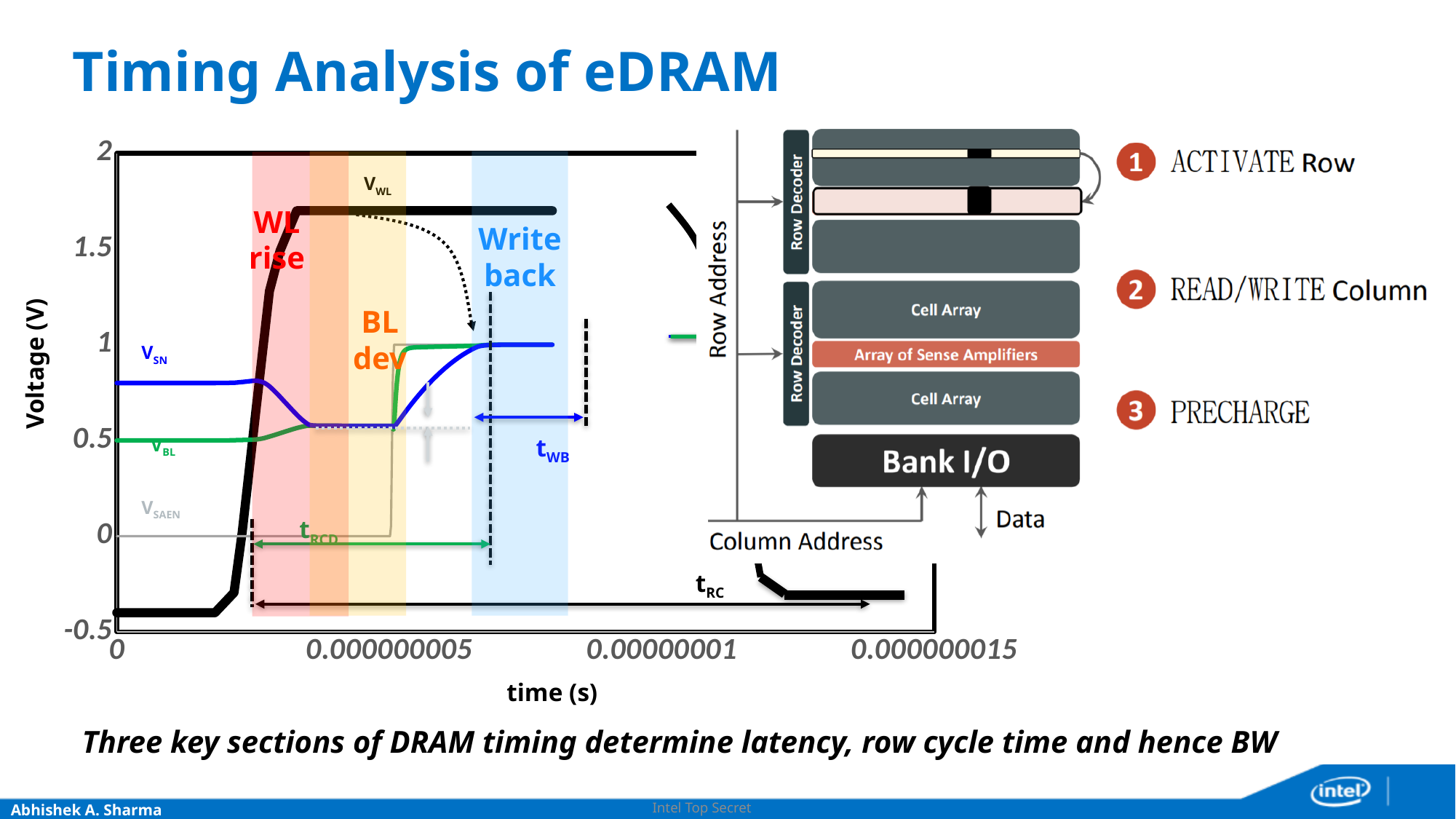
What is the label of the y axis of the chart? Voltage (V) What is the label of the x axis of the chart? time (s) Which labeled trace reaches the highest voltage in the chart? V_WL Does the V_SN trace rise or fall during the blue 'Write back' region? rise Is the plateau value of the V_WL trace greater or less than 1.5 V? greater At time 0, which trace has the higher voltage, V_SN or V_BL? V_SN Is the initial value of the V_SN trace (at time 0) greater or less than 0.5 V? greater What kind of chart is shown on the left of the slide? line chart Is the initial value of the V_BL trace (at time 0) greater or less than 1 V? less Does the V_WL trace rise or fall during the red 'WL rise' region? rise How many labeled voltage traces are plotted in the chart? 4